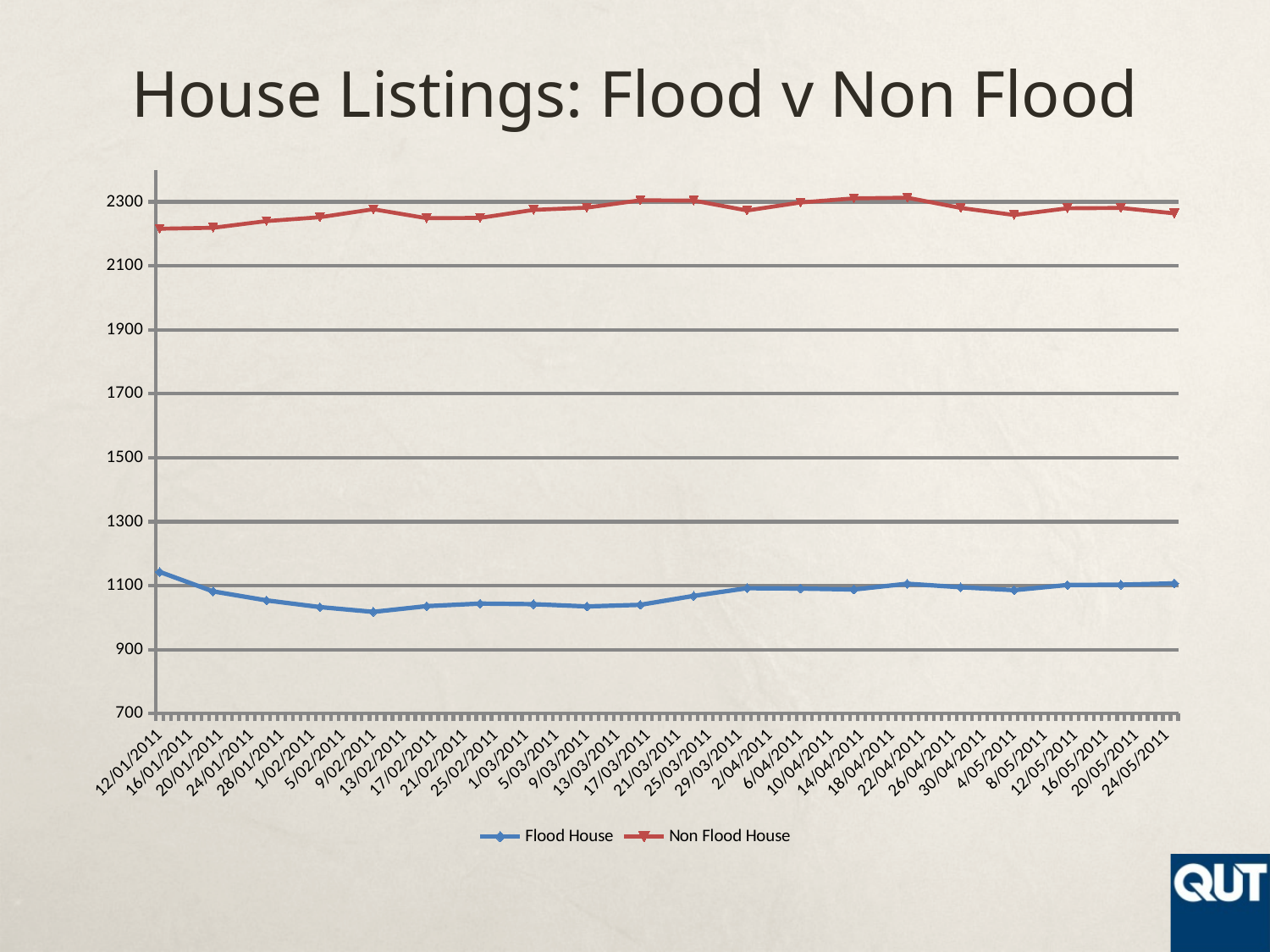
Is the value for Flood House on 12/01/2011 greater or less than 1100? greater Is the value for Flood House on 9/02/2011 greater or less than 1100? less What is the title of the chart? House Listings: Flood v Non Flood Does the Flood House series rise or fall between 12/01/2011 and 9/02/2011? fall Which series is drawn in red? Non Flood House On which date does the Flood House series reach its highest value? 12/01/2011 How many series does the legend list? 2 Is the value for Non Flood House on 12/01/2011 greater or less than 2300? less What kind of chart is shown on the slide? line chart On 24/05/2011, which series has the higher value, Flood House or Non Flood House? Non Flood House